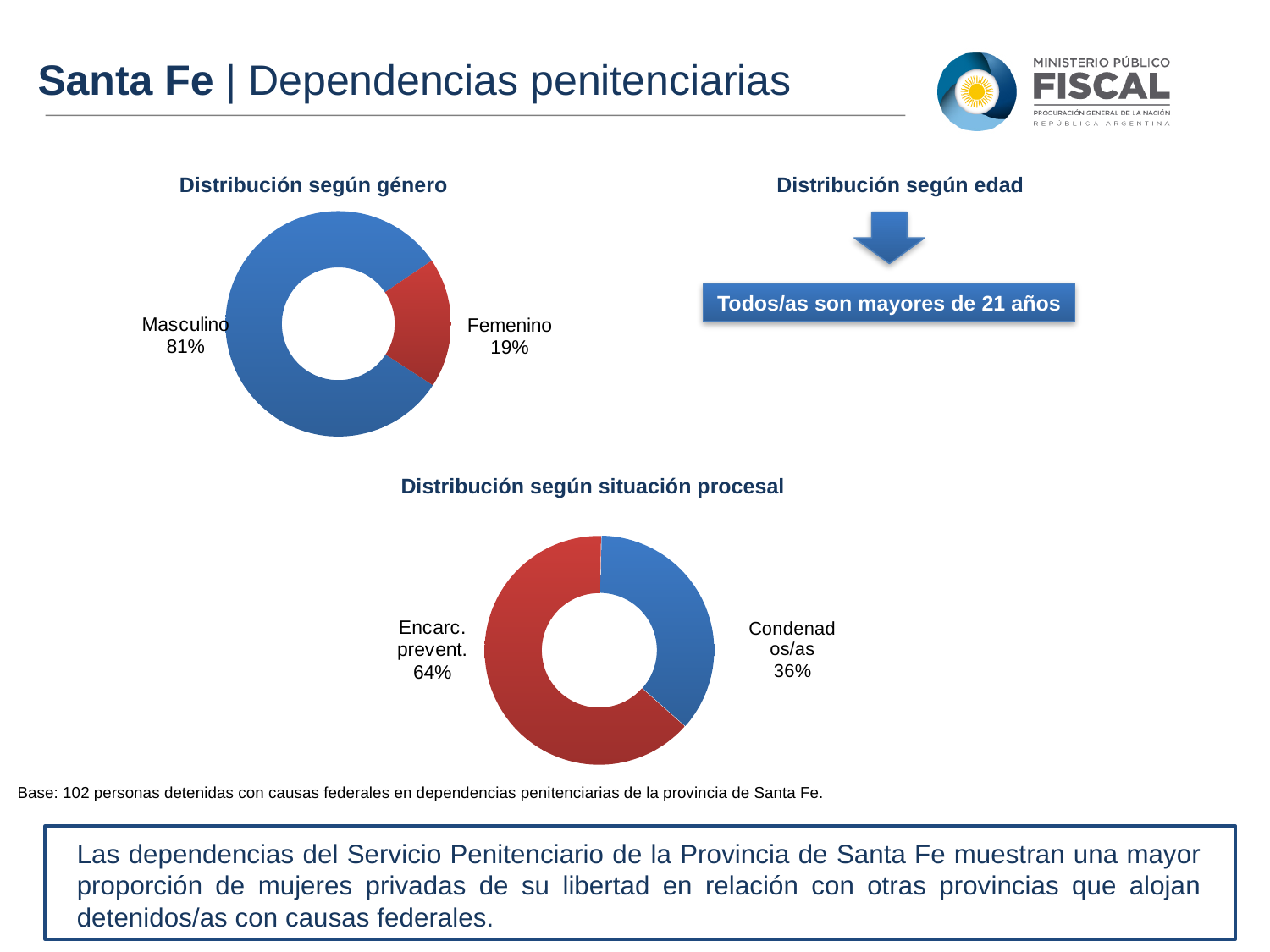
In the 'Distribución según género' chart, how many categories are shown? 2 In the 'Distribución según situación procesal' chart, what share is Condenados/as? 36% In the 'Distribución según situación procesal' chart, which category has the smallest share? Condenados/as In the 'Distribución según situación procesal' chart, what colour is the Encarc. prevent. slice? Red In the 'Distribución según género' chart, what share is Femenino? 19% In the 'Distribución según género' chart, what is the difference in percentage points between Masculino and Femenino? 62 What kind of chart is 'Distribución según género'? Pie chart (doughnut) In the 'Distribución según situación procesal' chart, what is the difference in percentage points between Encarc. prevent. and Condenados/as? 28 In the 'Distribución según género' chart, what share is Masculino? 81% In the 'Distribución según situación procesal' chart, is the share for Encarc. prevent. larger or smaller than the share for Condenados/as? Larger In the 'Distribución según género' chart, which category has the largest share? Masculino In the 'Distribución según situación procesal' chart, what share is Encarc. prevent.? 64%